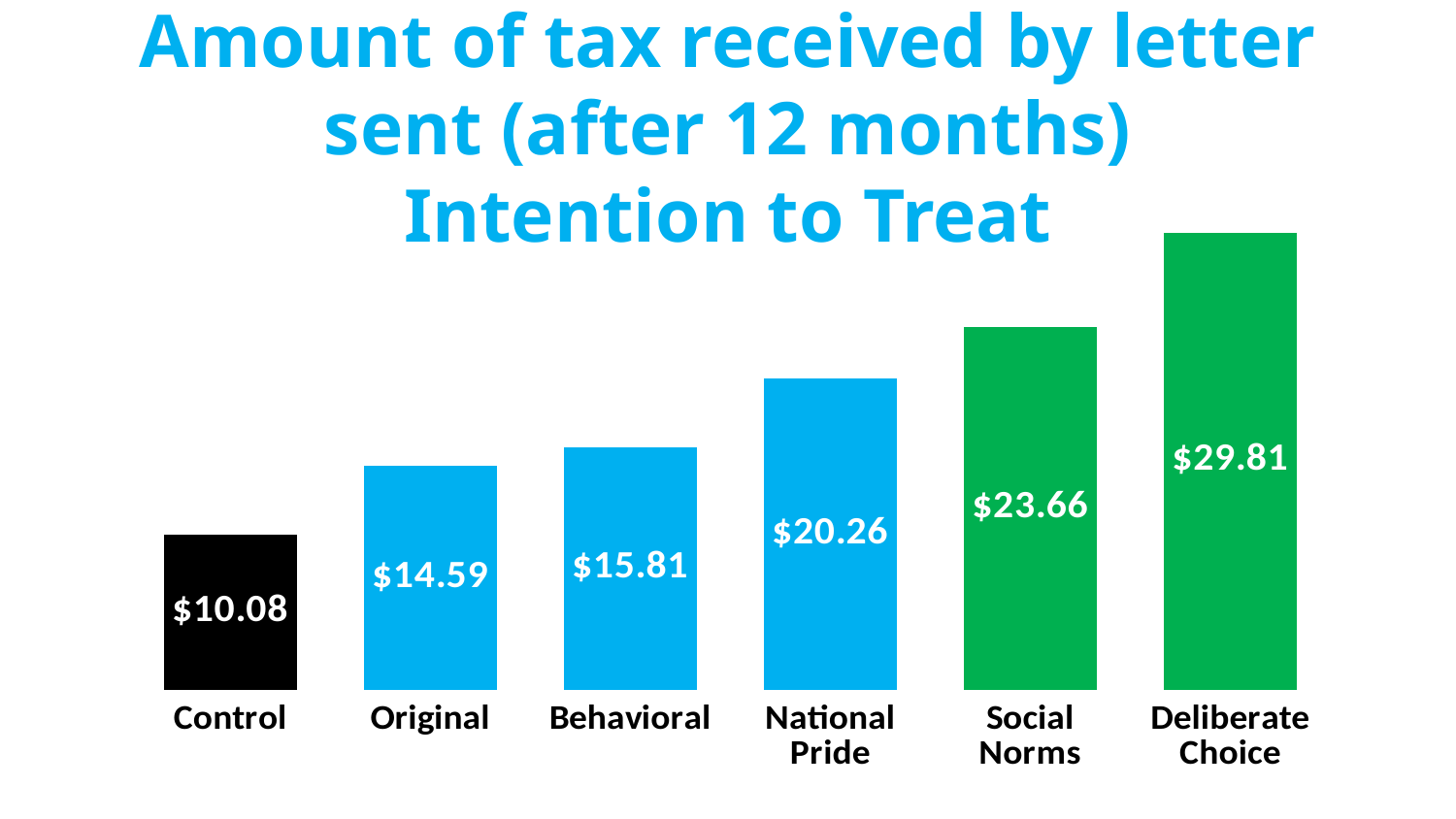
What is the value for National Pride? $20.26 Which category has the highest value? Deliberate Choice How many categories are shown in the chart? 6 Which is larger, Social Norms or National Pride? Social Norms Which category has the lowest value? Control What is the difference between Behavioral and Original? $1.22 What is the value for Control? $10.08 What is the value for Social Norms? $23.66 What colour is the Control bar? Black What is the difference between Deliberate Choice and Control? $19.73 What kind of chart is this? Bar chart Do the values rise or fall from left to right along the x axis? Rise